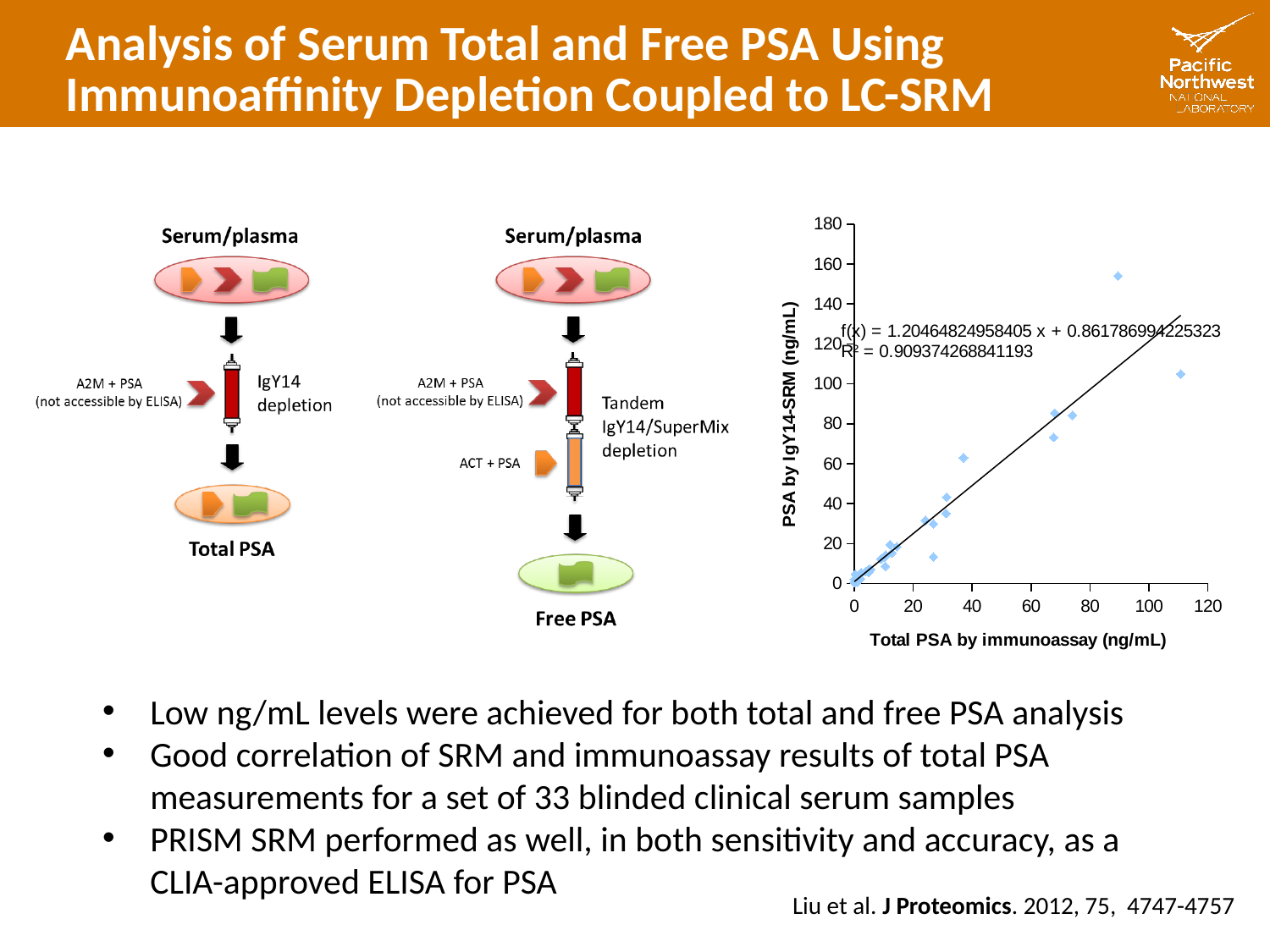
Is the y value of the point with the largest Total PSA by immunoassay (around 110 ng/mL) greater or less than 120? less What kind of chart is shown on the right side of the slide? scatter chart What is the maximum value shown on the x axis of the scatter chart? 120 What R² value is printed on the scatter chart? 0.909374268841193 Is the y value of the point at about 38 ng/mL Total PSA by immunoassay greater or less than 40? greater What is the label of the y axis of the scatter chart? PSA by IgY14-SRM (ng/mL) What is the label of the x axis of the scatter chart? Total PSA by immunoassay (ng/mL) What is the intercept of the fitted line shown in the scatter chart equation? 0.861786994225323 Is the y value of the highest point in the scatter chart greater or less than 140? greater What is the slope of the fitted line shown in the scatter chart equation? 1.20464824958405 Do the plotted points in the scatter chart generally rise or fall as Total PSA by immunoassay increases? rise What is the maximum value shown on the y axis of the scatter chart? 180